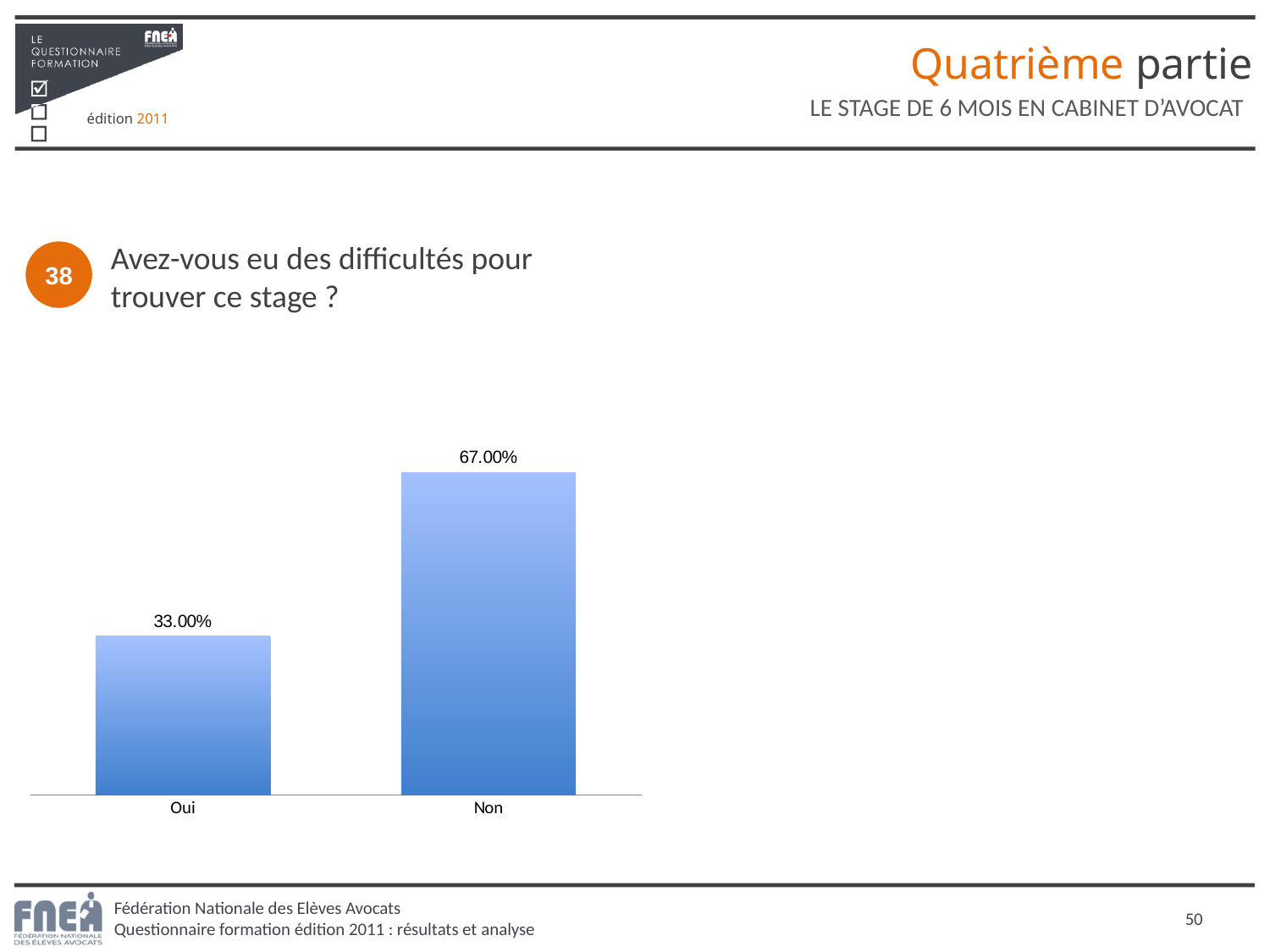
What is the question number shown next to the chart's question? 38 What is the total of the two values shown in the chart? 100.00% Which category has the highest value? Non Which category has the lowest value? Oui Which is larger, the value for "Oui" or the value for "Non"? Non How many categories are shown in the chart? 2 What kind of chart is shown on the slide? Bar chart What is the value for "Oui"? 33.00% What question does the chart answer? Avez-vous eu des difficultés pour trouver ce stage ? What is the value for "Non"? 67.00% What is the difference between the values for "Non" and "Oui"? 34.00%